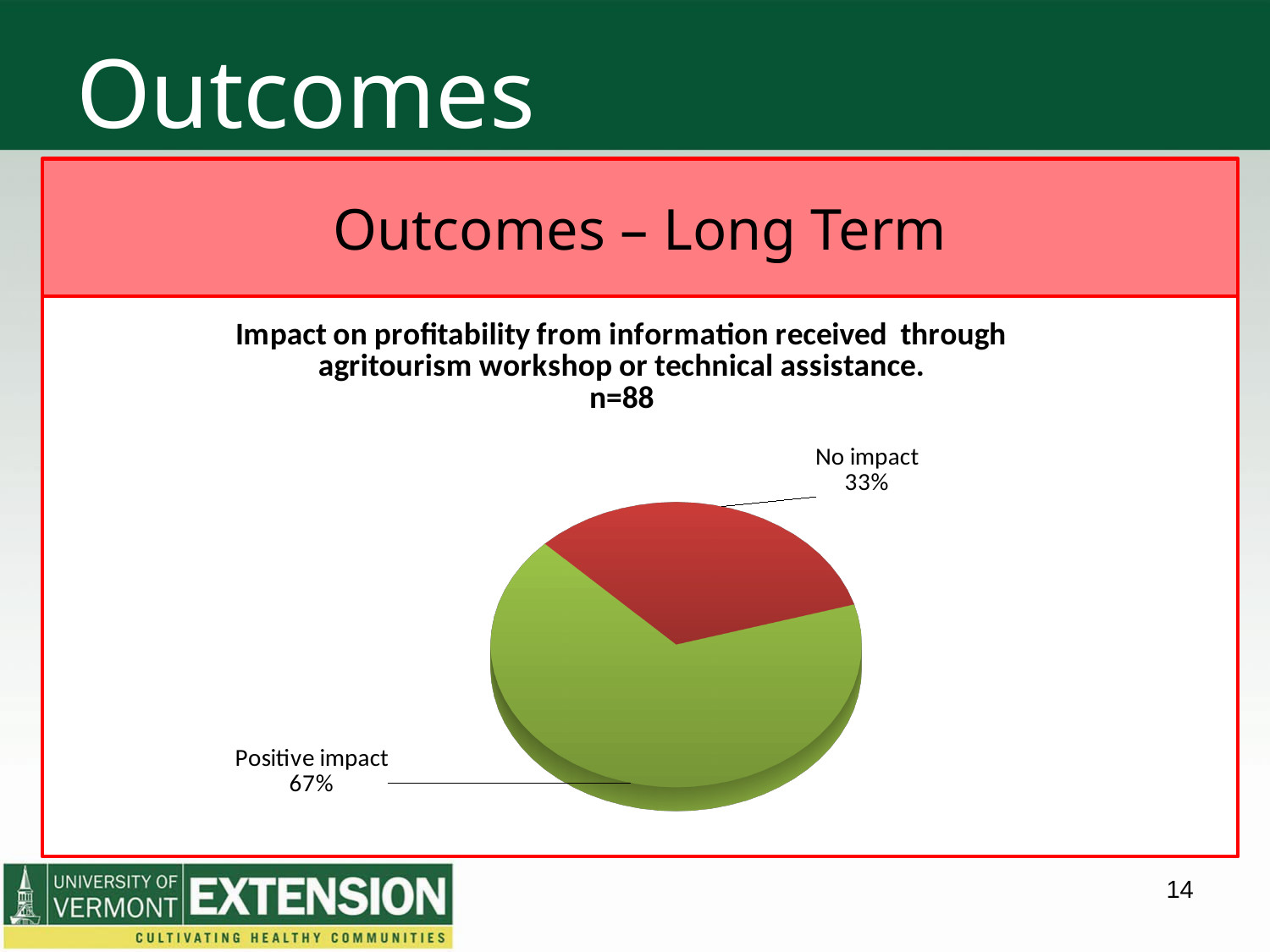
Which is larger: the share for Positive impact or the share for No impact? Positive impact What is the sample size (n) stated in the chart title? n=88 What type of chart is shown on the slide? Pie chart What percentage of respondents reported a positive impact on profitability? 67% What colour is the Positive impact slice of the pie chart? Green What share of the pie does the No impact slice represent? 33% Which slice of the pie chart is the smallest? No impact What is the difference in percentage points between the Positive impact and No impact slices? 34 Which slice of the pie chart is the largest? Positive impact How many slices does the pie chart have? 2 What percentage of respondents reported no impact on profitability? 33%